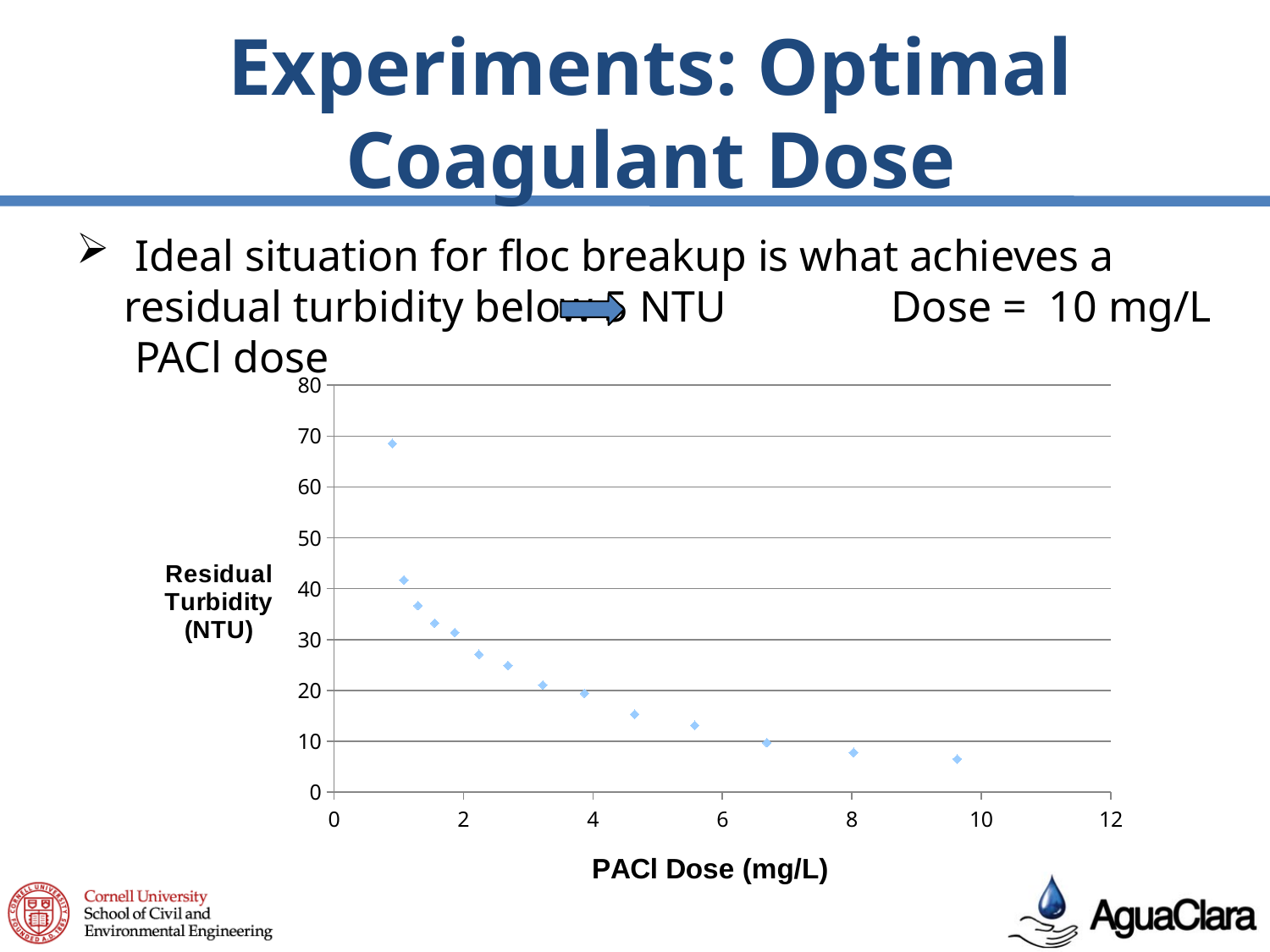
How many data points are plotted on the chart? 14 What kind of chart is shown on the slide? scatter chart Which point has the highest residual turbidity: the one at the lowest PACl dose or the one at the highest PACl dose? the one at the lowest PACl dose Which has the larger residual turbidity: the point at a PACl dose of about 2 mg/L or the point at about 8 mg/L? the point at about 2 mg/L Is the residual turbidity for the point at a PACl dose of about 2 mg/L greater or less than 20? greater What is the maximum value shown on the y axis of the chart? 80 Is the residual turbidity for the leftmost point (PACl dose of about 1 mg/L) greater or less than 60? greater What is the label of the x axis of the chart? PACl Dose (mg/L) As PACl dose increases along the x axis, does residual turbidity rise or fall? fall Is the residual turbidity for the point at a PACl dose of about 5.5 mg/L greater or less than 20? less What is the label of the y axis of the chart? Residual Turbidity (NTU)